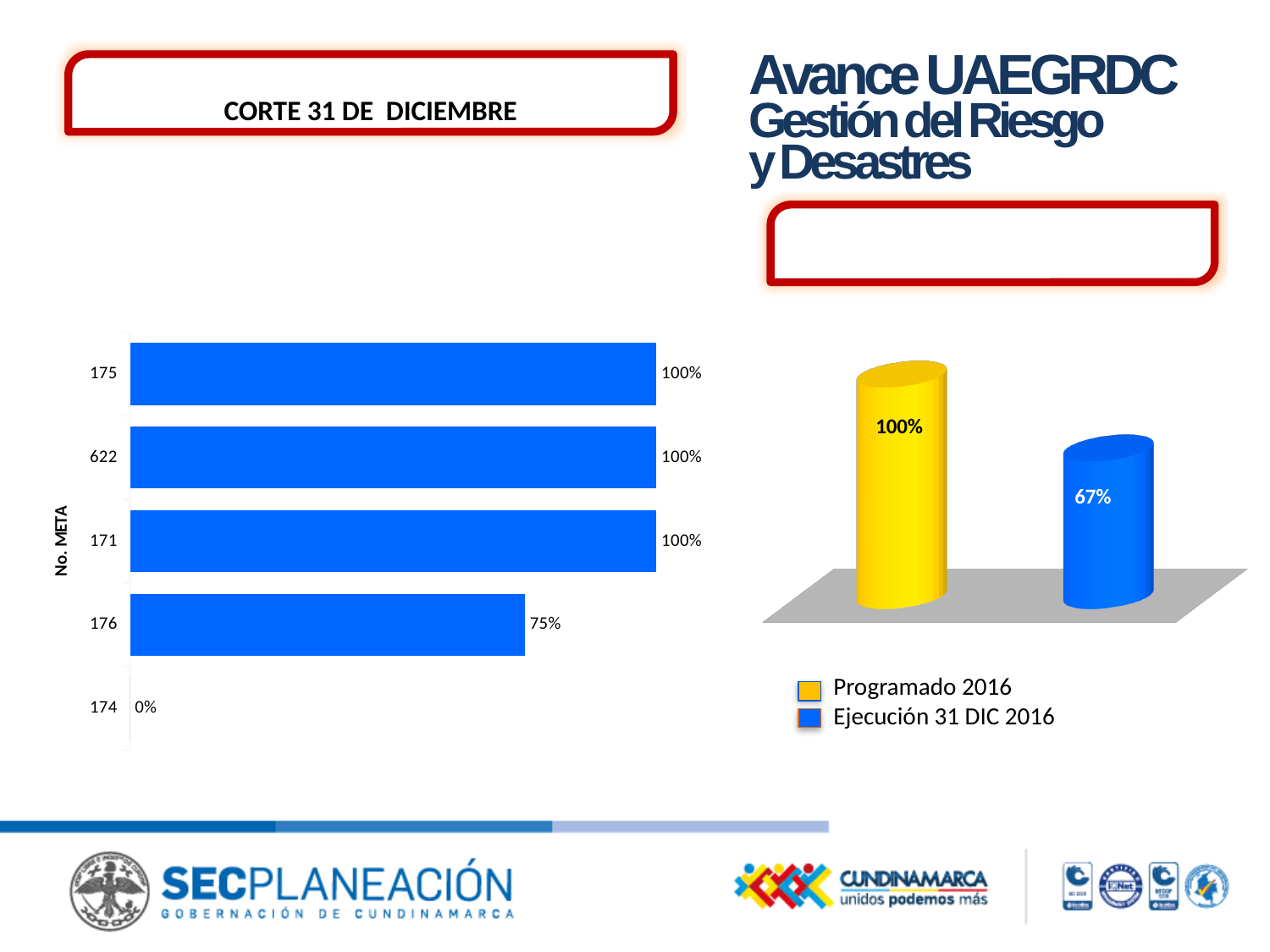
In the right chart, what is the difference between Programado 2016 and Ejecución 31 DIC 2016? 33% In the left bar chart, how many metas are listed on the vertical axis? 5 In the right chart, what is the value for Ejecución 31 DIC 2016? 67% In the right chart, what is the value for Programado 2016? 100% How many entries does the legend of the right chart list? 2 In the left bar chart, which is larger, the value for meta 176 or the value for meta 174? 176 In the left bar chart, what is the value for meta 622? 100% In the left bar chart, what is the difference between the values for meta 171 and meta 176? 25% In the left bar chart, which meta has the lowest value? 174 In the left bar chart, what is the value for meta 176? 75% In the left bar chart, what is the value for meta 174? 0% What kind of chart is the chart on the left of the slide? Bar chart